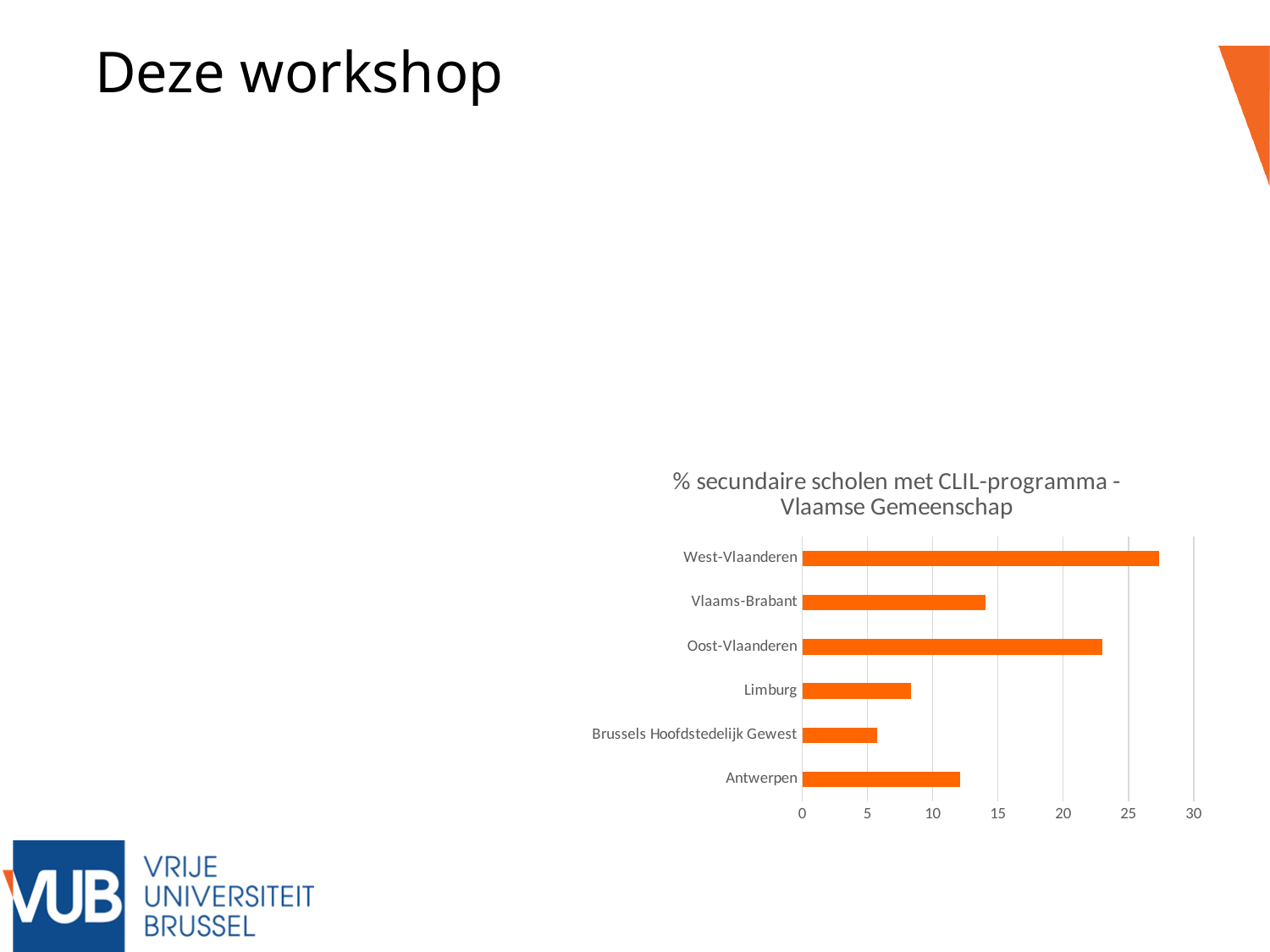
How many categories are shown in the chart? 6 Which has a larger value, Oost-Vlaanderen or Vlaams-Brabant? Oost-Vlaanderen Is the value for Antwerpen greater or less than 10? greater What kind of chart is shown on the slide? bar chart What is the title of the chart? % secundaire scholen met CLIL-programma - Vlaamse Gemeenschap Is the value for Limburg greater or less than 10? less Which category has the lowest value? Brussels Hoofdstedelijk Gewest What colour are the bars in the chart? orange Which category has the highest value? West-Vlaanderen Is the value for West-Vlaanderen greater or less than 25? greater Which has a larger value, Antwerpen or Limburg? Antwerpen